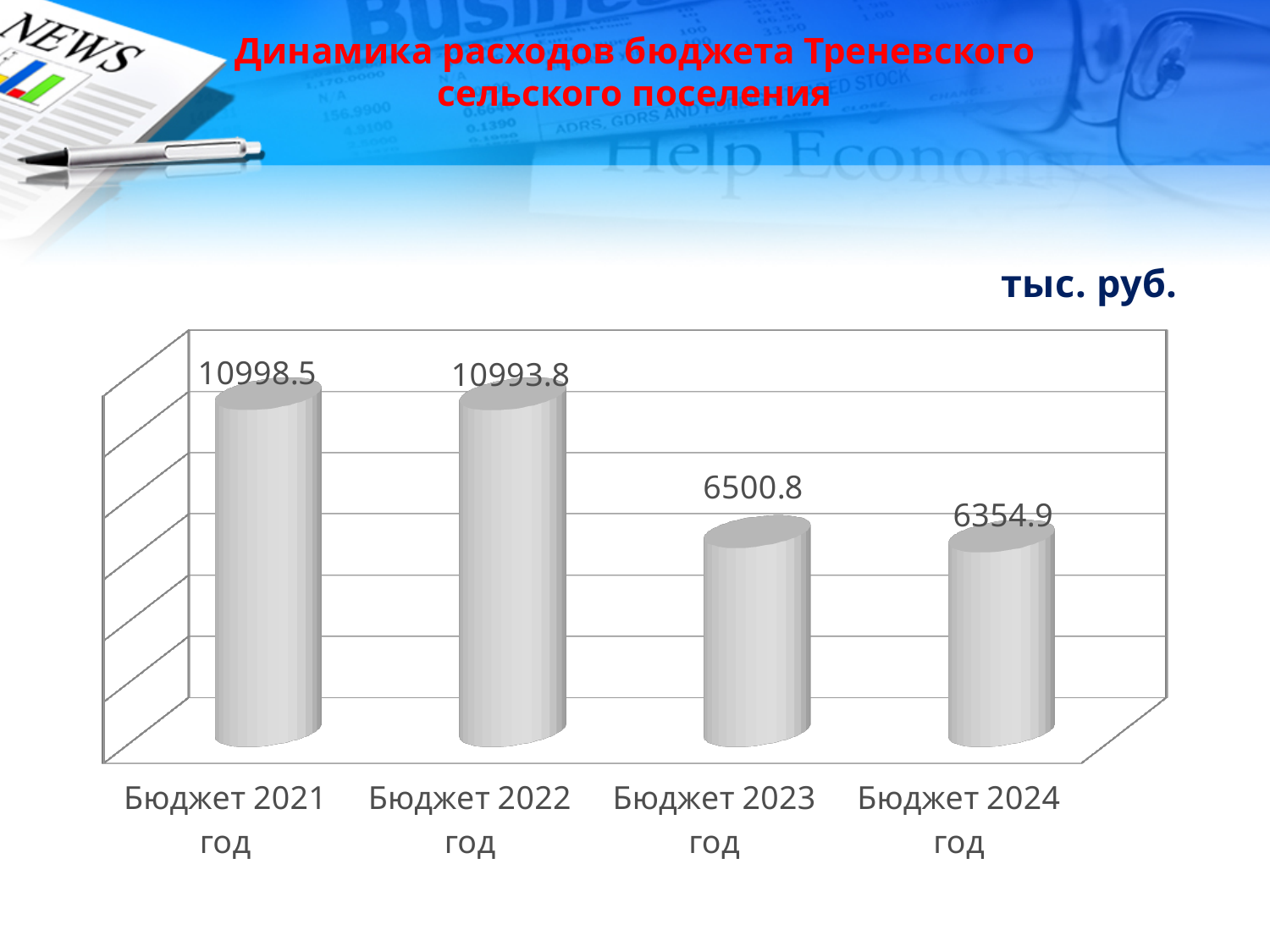
Which category has the highest value? Бюджет 2021 год What is the difference between the values for Бюджет 2021 год and Бюджет 2023 год? 4497.7 In what units are the chart values given? тыс. руб. What is the difference between the values for Бюджет 2023 год and Бюджет 2024 год? 145.9 What is the value for Бюджет 2021 год? 10998.5 What kind of chart is shown on the slide? Bar chart Do the values rise or fall from Бюджет 2021 год to Бюджет 2024 год? Fall How many categories are shown in the chart? 4 What is the value for Бюджет 2024 год? 6354.9 What is the value for Бюджет 2023 год? 6500.8 Which category has the lowest value? Бюджет 2024 год Which is larger, the value for Бюджет 2022 год or Бюджет 2024 год? Бюджет 2022 год